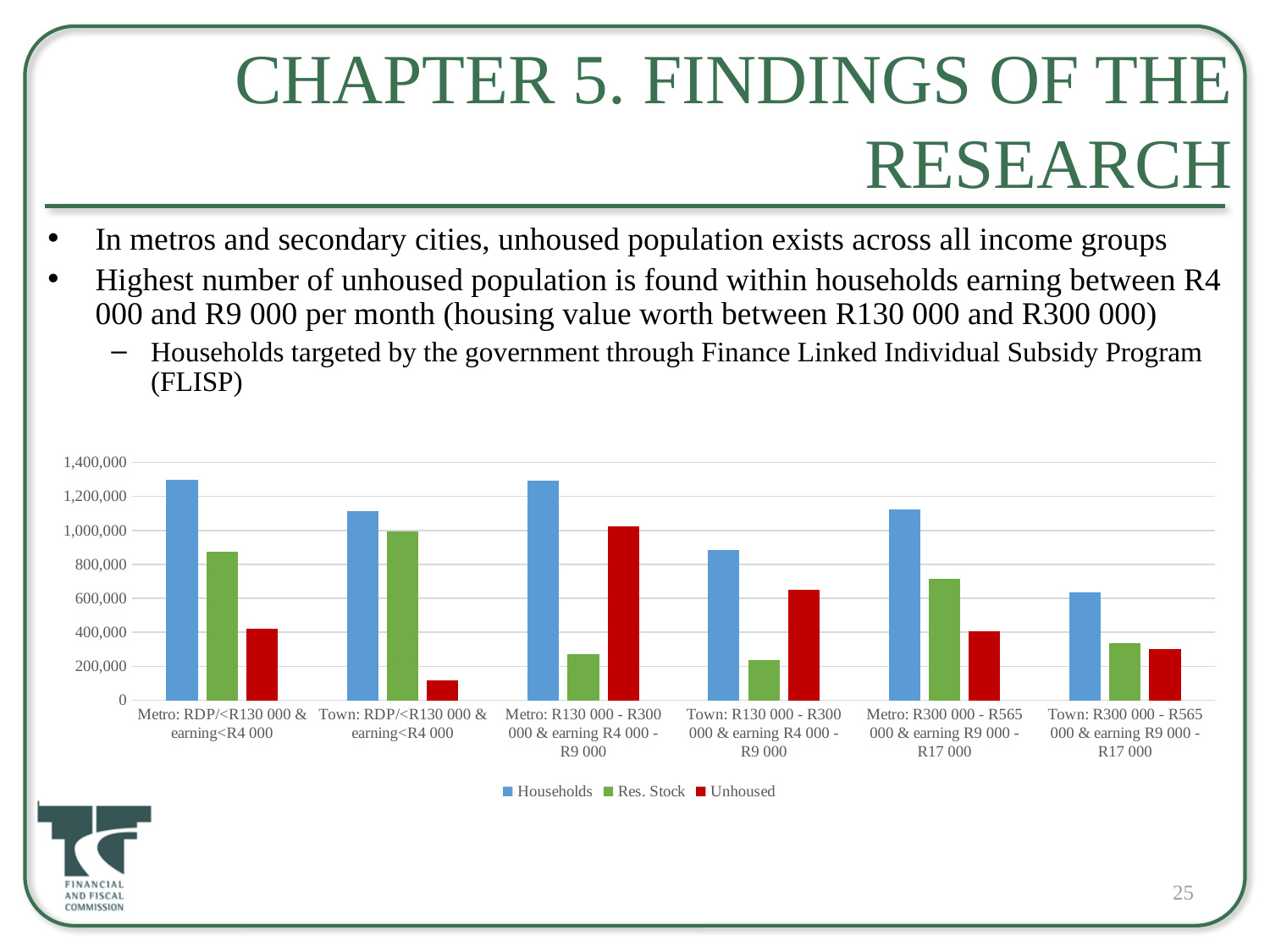
How many categories are shown along the x axis of the chart? 6 How many series does the chart legend list? 3 Is the Unhoused value for Metro: R130 000 - R300 000 & earning R4 000 - R9 000 greater or less than 800,000? greater Is the Unhoused value for Town: RDP/<R130 000 & earning<R4 000 greater or less than 200,000? less Is the Households value for Metro: RDP/<R130 000 & earning<R4 000 greater or less than 1,200,000? greater In the Town: RDP/<R130 000 & earning<R4 000 category, which is larger, Res. Stock or Unhoused? Res. Stock Which category has the highest Unhoused value? Metro: R130 000 - R300 000 & earning R4 000 - R9 000 Which category has the lowest Unhoused value? Town: RDP/<R130 000 & earning<R4 000 What kind of chart is shown on the slide? Bar chart Which category has the lowest Households value? Town: R300 000 - R565 000 & earning R9 000 - R17 000 What are the three series named in the chart legend? Households, Res. Stock, Unhoused Which category has the highest Res. Stock value? Town: RDP/<R130 000 & earning<R4 000